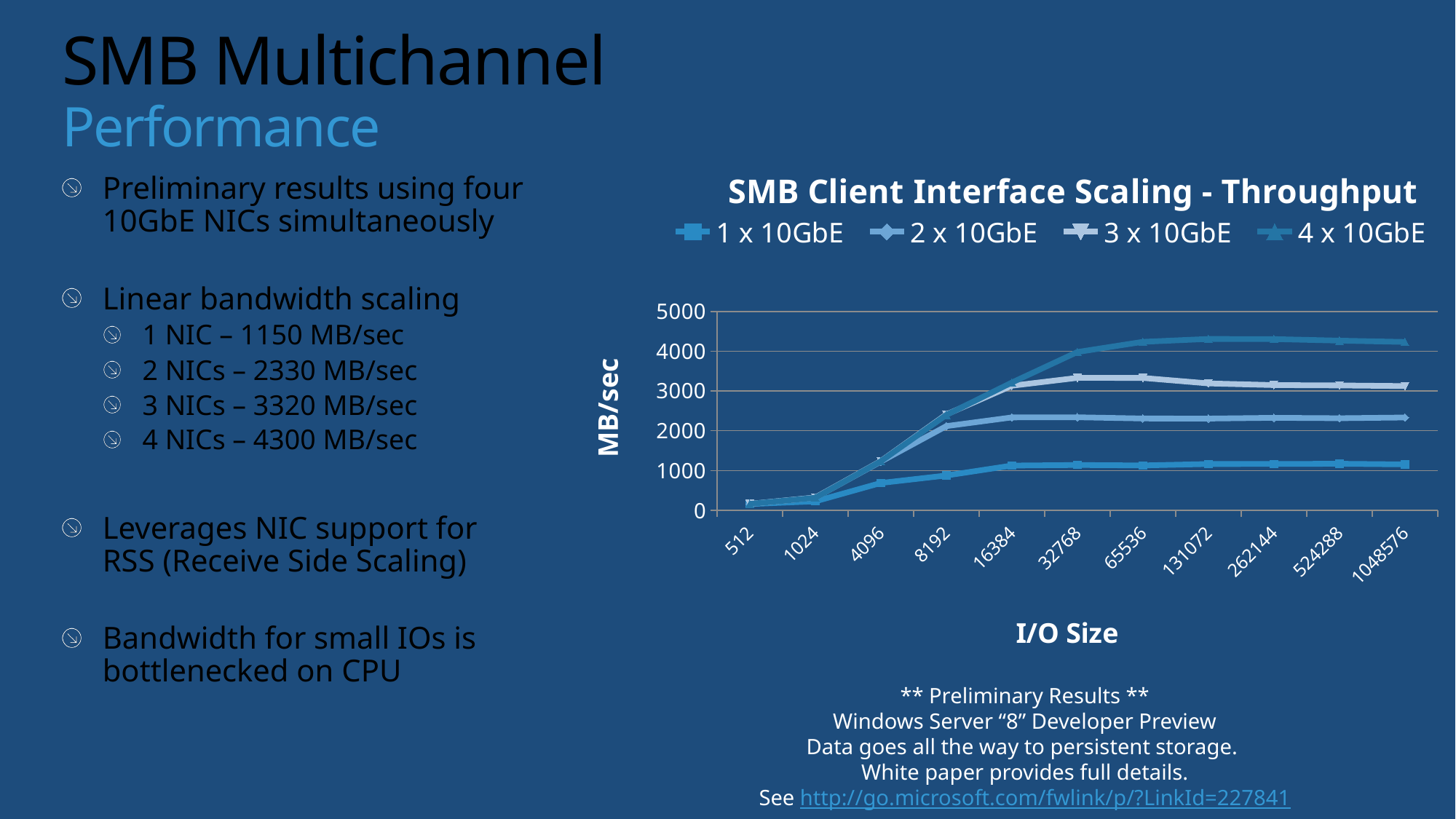
How many series does the chart legend list? 4 Does the 4 x 10GbE series rise or fall from I/O size 512 to 32768? rise Is the value for 1 x 10GbE at I/O size 1048576 greater or less than 2000? less Which series has the highest throughput at I/O size 1048576? 4 x 10GbE What is the title of the chart? SMB Client Interface Scaling - Throughput Is the value for 4 x 10GbE at I/O size 1048576 greater or less than 4000? greater At I/O size 16384, which is larger: the value for 3 x 10GbE or 2 x 10GbE? 3 x 10GbE Which series has the lowest throughput at I/O size 1048576? 1 x 10GbE What is the label of the y axis? MB/sec How many I/O size categories are shown on the x axis? 11 What kind of chart is shown on the slide? line chart Is the value for 3 x 10GbE at I/O size 32768 greater or less than 3000? greater